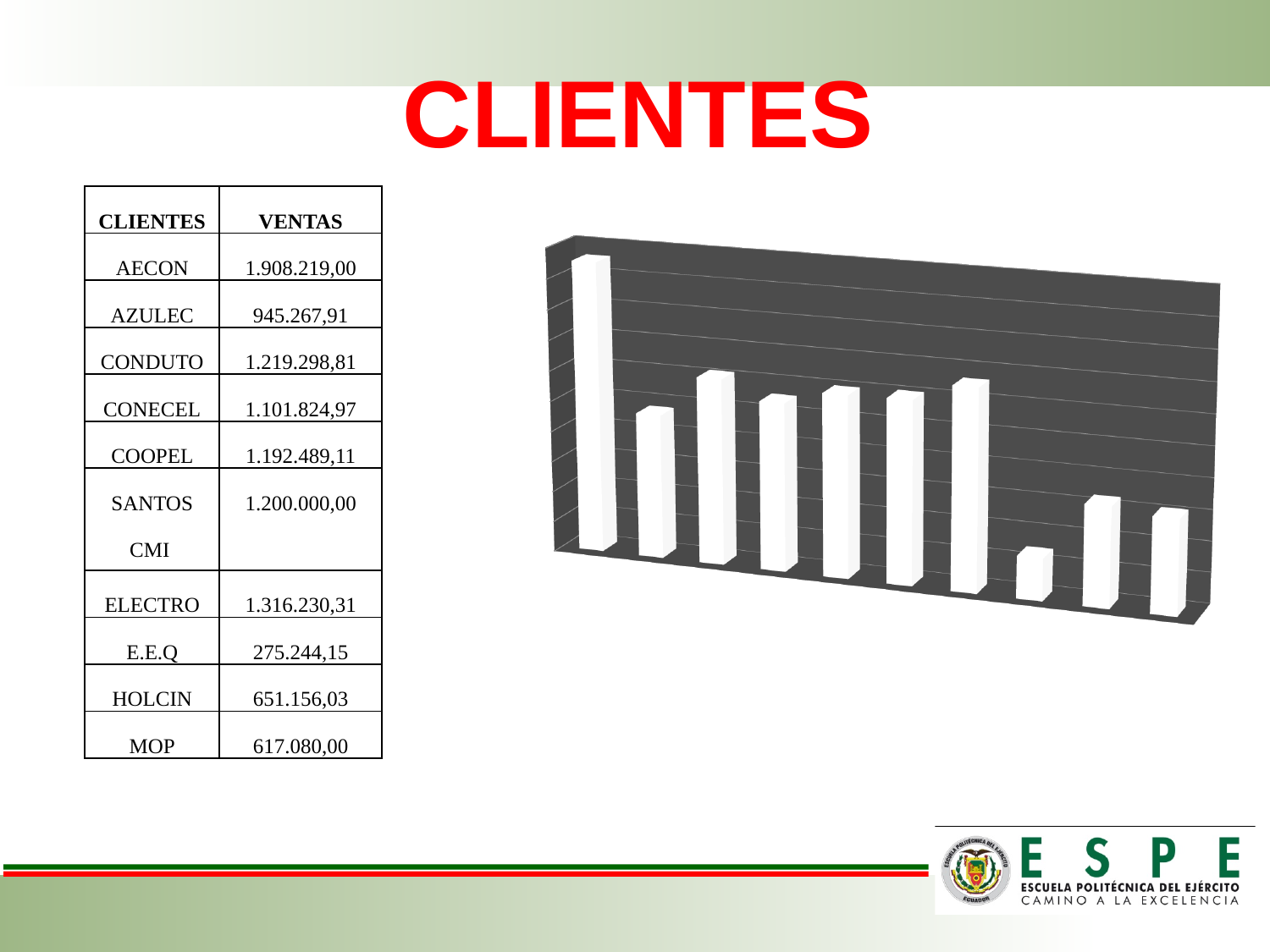
Which bar in the chart is the tallest, counting from the left? the first bar Which bar in the chart is the shortest, counting from the left? the eighth bar In the chart, is the third bar from the left taller or shorter than the second bar? taller In the chart, is the ninth bar from the left taller or shorter than the eighth bar? taller How many bars does the chart on the right of the slide contain? 10 In the chart, is the seventh bar from the left taller or shorter than the tenth bar? taller What kind of chart is shown on the right of the slide? bar chart Does the chart on the slide display a legend? No Does the chart on the slide show axis labels or data labels on its bars? No